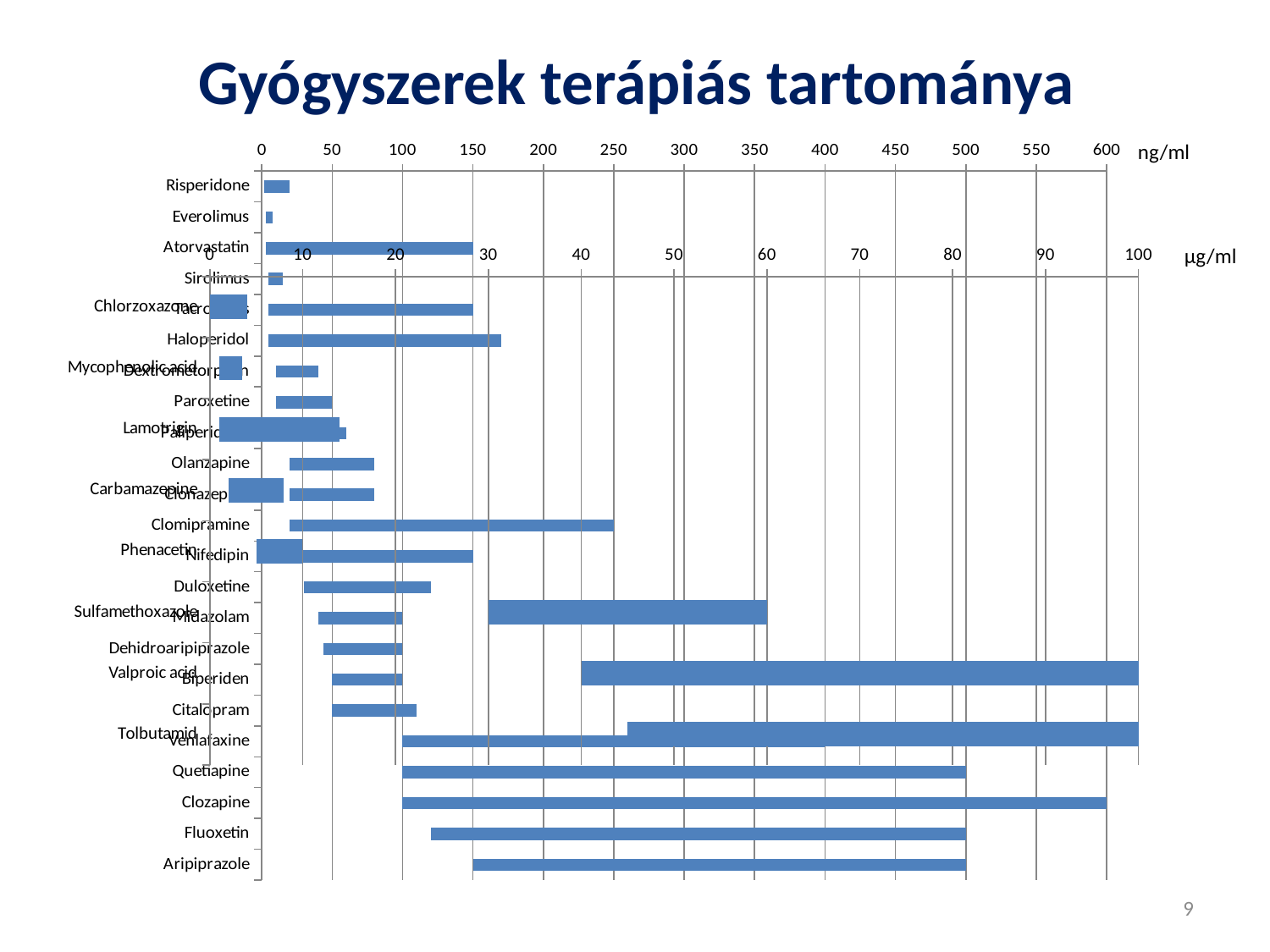
On the ng/ml chart, which bar reaches a higher upper value, Clozapine or Risperidone? Clozapine On the µg/ml chart, is the upper end of the Lamotrigin bar greater or less than 20? less On the ng/ml chart, is the upper end of the Everolimus bar greater or less than 50? less What is the title of the slide's chart? Gyógyszerek terápiás tartománya On the µg/ml chart, is the upper end of the Sulfamethoxazole bar greater or less than 50? greater What unit is shown on the upper horizontal axis (0 to 600)? ng/ml What kind of chart is used to show the therapeutic ranges? bar chart